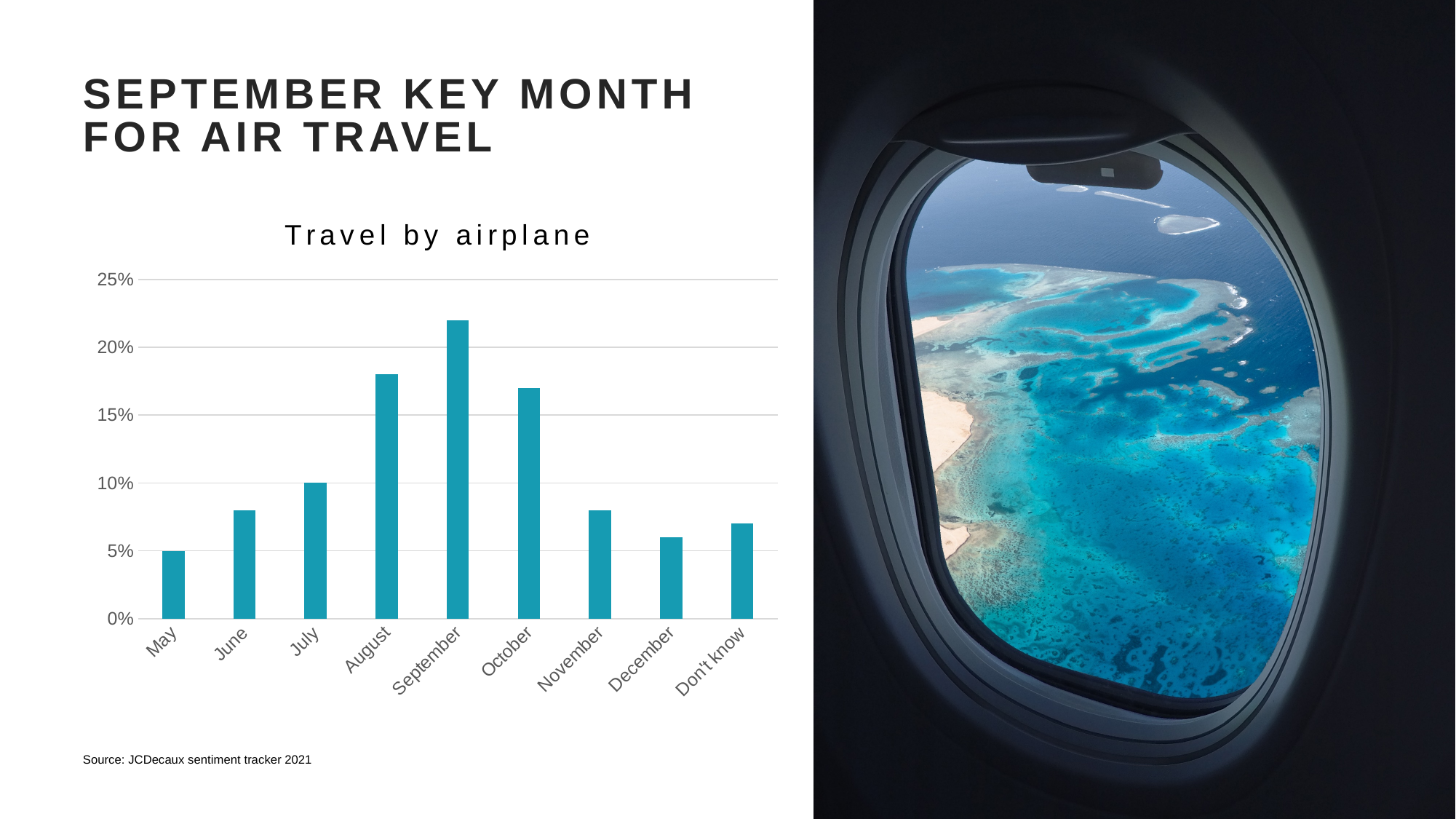
What is the value for May? 5% What type of chart is shown on the slide? bar chart What is the value for July? 10% Which category has the lowest value in the chart? May Which is larger, the value for August or the value for October? August Do the values rise or fall from May to September? rise What is the title of the chart? Travel by airplane Is the value for December greater or less than 10%? less Is the value for September greater or less than 20%? greater Is the value for August greater or less than 15%? greater How many categories are shown on the x axis of the chart? 9 Which month has the highest value in the chart? September